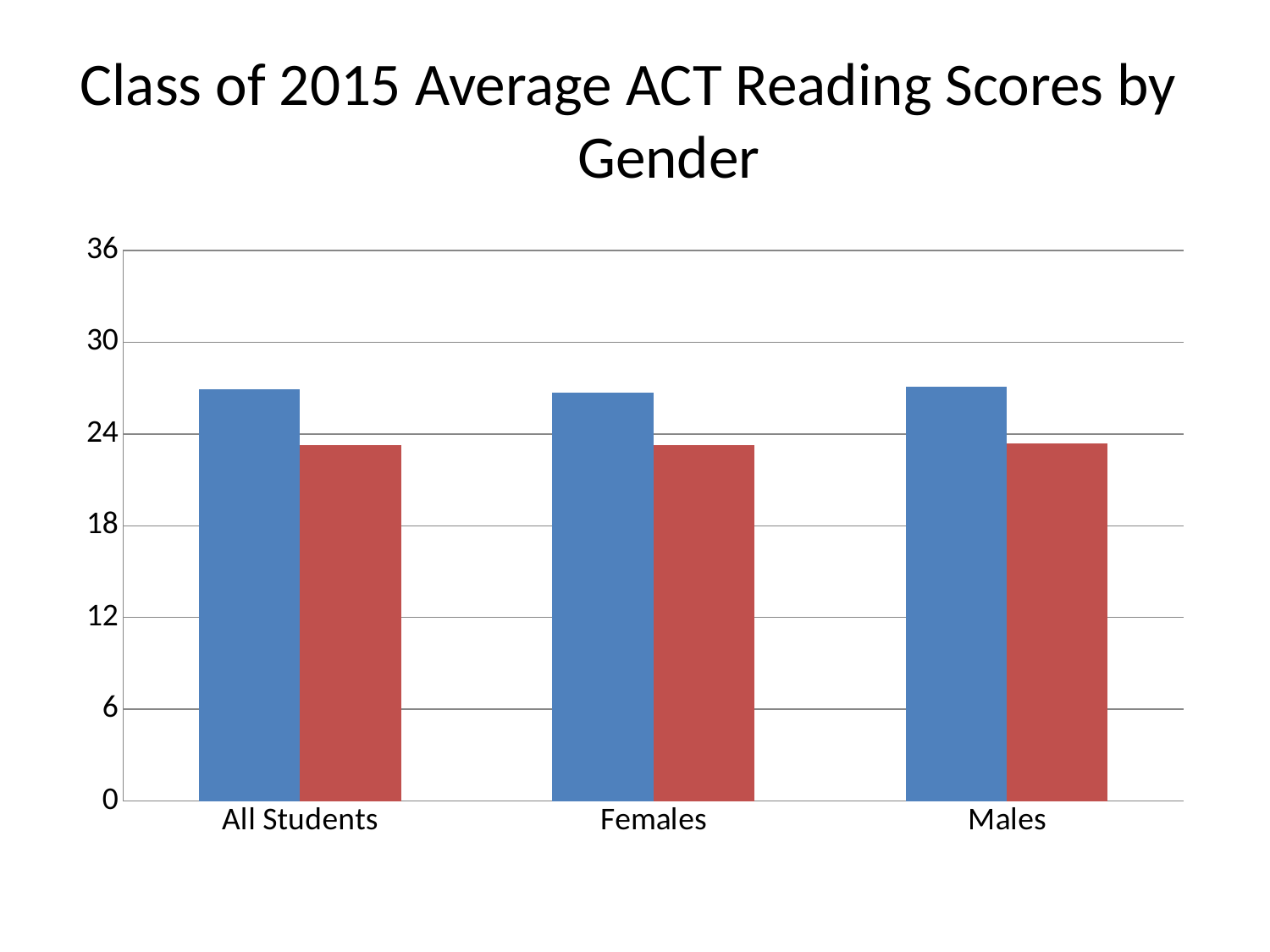
What kind of chart is shown on the slide? bar chart Is the value of the red bar for Males greater or less than 18? greater For Males, which bar is taller, the blue bar or the red bar? the blue bar For Females, which bar is taller, the blue bar or the red bar? the blue bar What is the title of the chart? Class of 2015 Average ACT Reading Scores by Gender Is the value of the blue bar for All Students greater or less than 24? greater Is the value of the red bar for Females greater or less than 24? less For All Students, which bar is shorter, the blue bar or the red bar? the red bar How many categories are shown on the x axis? 3 What two colours are the bars in the chart? blue and red